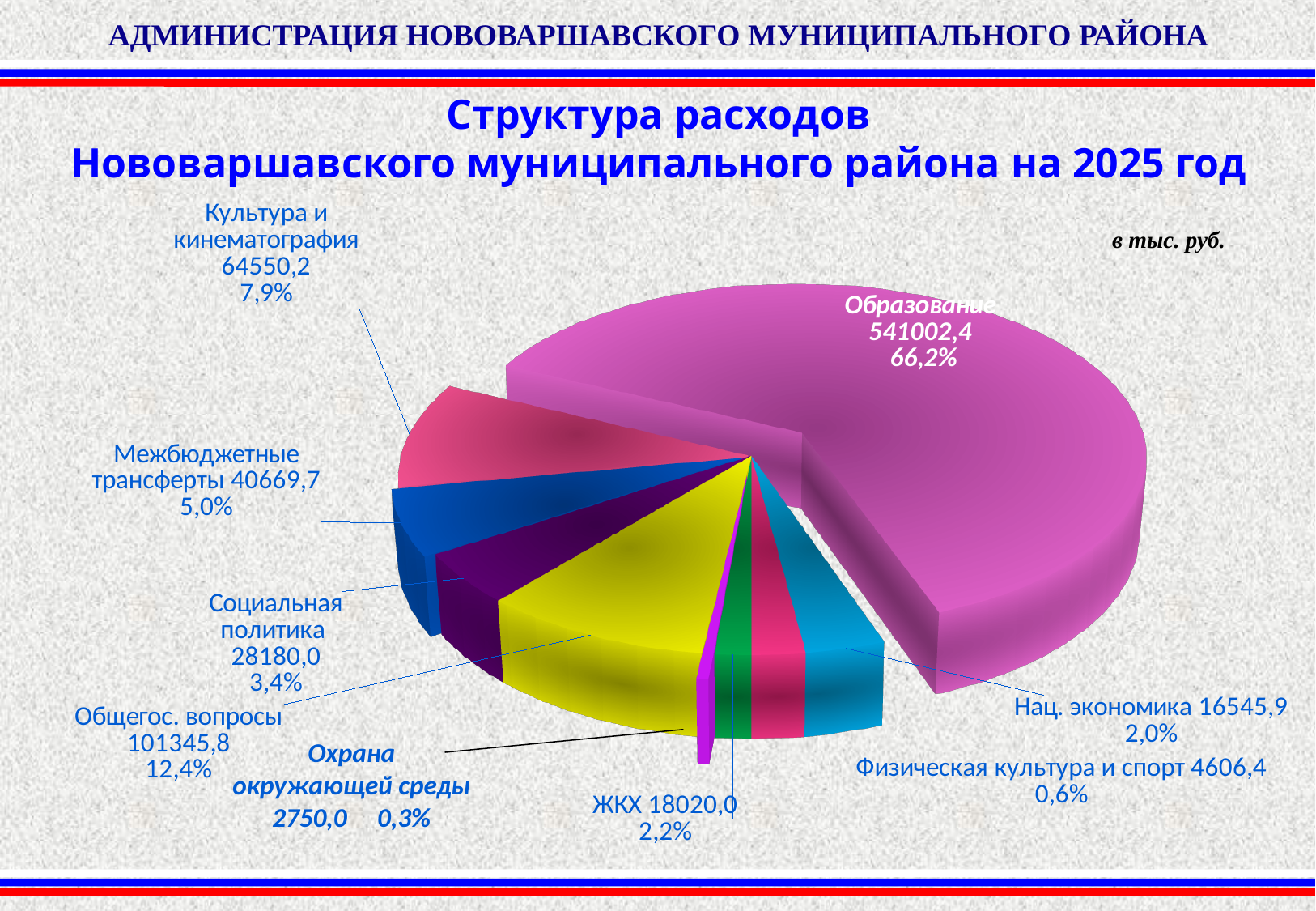
Which category has the largest slice? Образование What is the value for Охрана окружающей среды? 2750,0 What is the value for Общегос. вопросы? 101345,8 What is the value for Образование? 541002,4 What kind of chart is shown on the slide? pie chart In what units are the values on the chart given? тыс. руб. What share of the pie does Культура и кинематография take? 7,9% What share of the pie does Образование take? 66,2% Which category has the smallest slice? Охрана окружающей среды Which is larger, Межбюджетные трансферты or Социальная политика? Межбюджетные трансферты How many categories does the pie chart have? 9 What is the difference between the values for ЖКХ and Нац. экономика? 1474,1